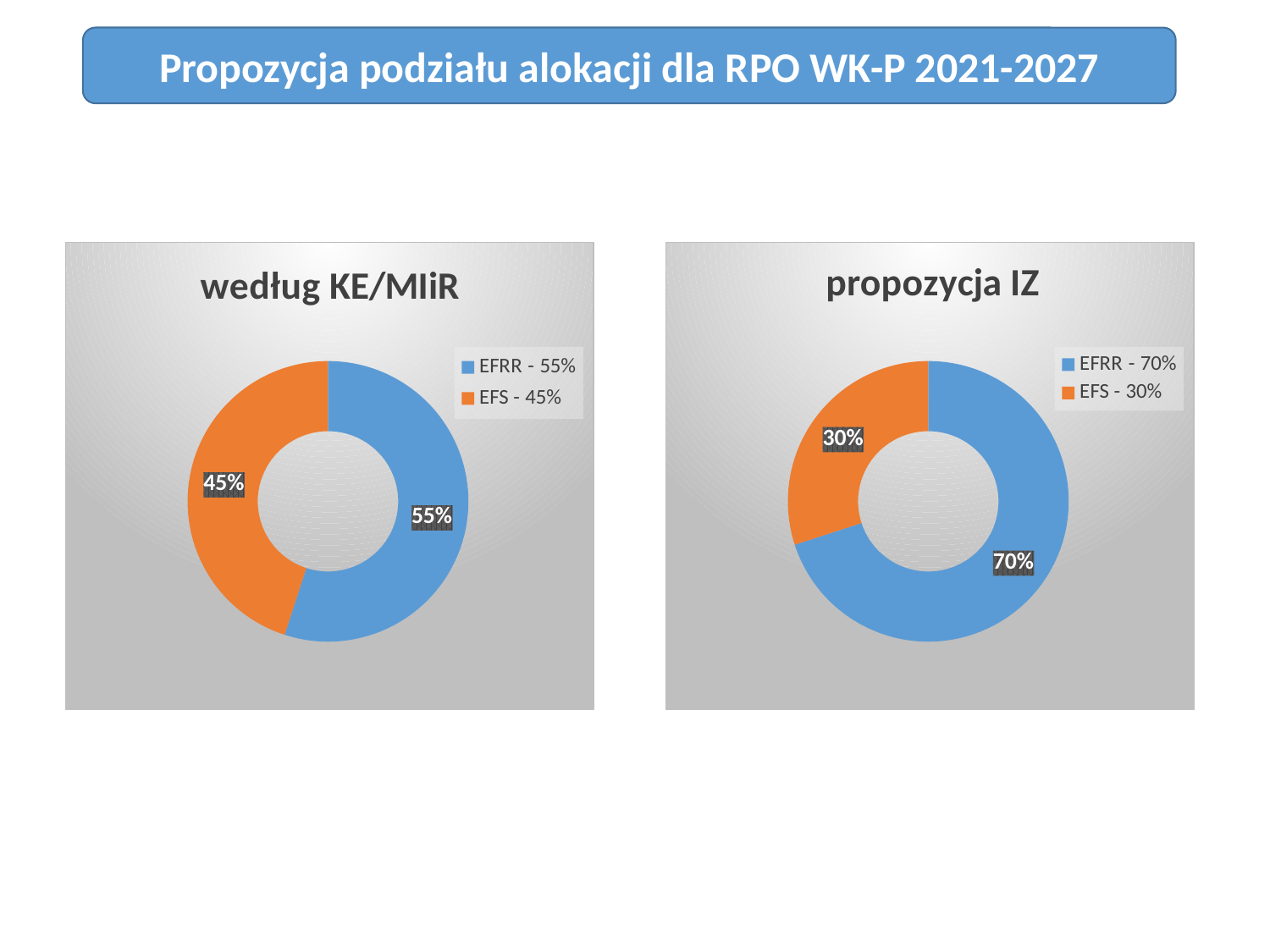
In the 'według KE/MIiR' chart, what share does EFS have? 45% Which chart shows a larger share for EFRR, 'według KE/MIiR' or 'propozycja IZ'? propozycja IZ In the 'według KE/MIiR' chart, which slice is the smallest? EFS What kind of chart is the 'według KE/MIiR' chart? Doughnut (pie) chart In the 'według KE/MIiR' chart, what share does EFRR have? 55% In the 'propozycja IZ' chart, what share does EFRR have? 70% In the 'propozycja IZ' chart, which slice is the largest? EFRR In the 'propozycja IZ' chart, what share does EFS have? 30% In the 'propozycja IZ' chart, what colour is the EFS slice? Orange In the 'według KE/MIiR' chart, what is the difference between the EFRR and EFS shares? 10% In the 'propozycja IZ' chart, what is the difference between the EFRR and EFS shares? 40% How many slices does the 'propozycja IZ' chart have? 2